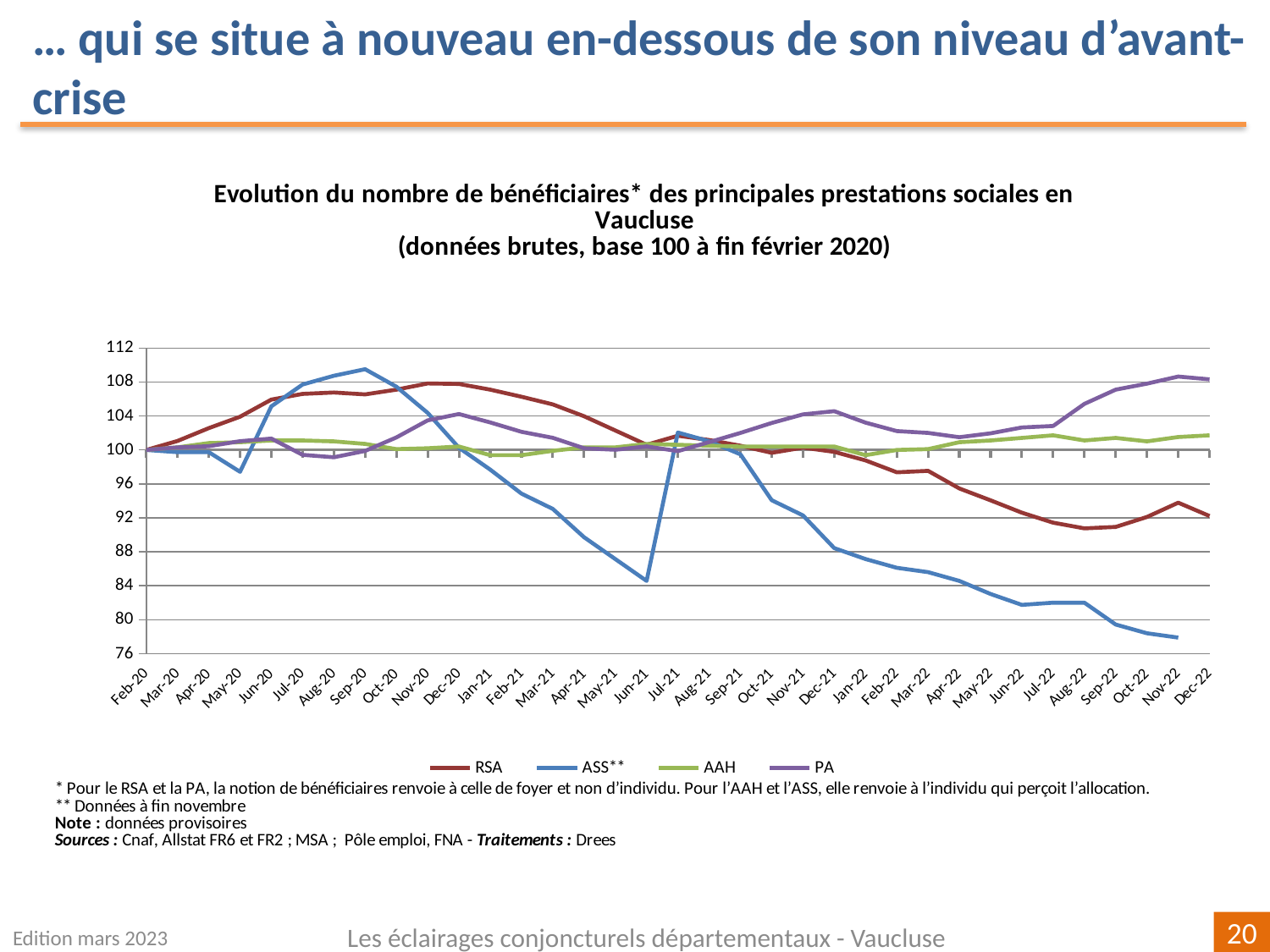
What is the value of the RSA series in Feb-20? 100 Is the value for PA in Nov-22 greater or less than 104? greater Which series has the highest value in Dec-22? PA Is the value for RSA in Nov-20 greater or less than 104? greater What kind of chart is shown on the slide? line chart Which series are listed in the legend? RSA, ASS**, AAH, PA In Sep-20, which series is higher, ASS** or RSA? ASS** How many series does the legend list? 4 Is the value for RSA in Aug-22 greater or less than 92? less Which series has the lowest value in Dec-22? RSA